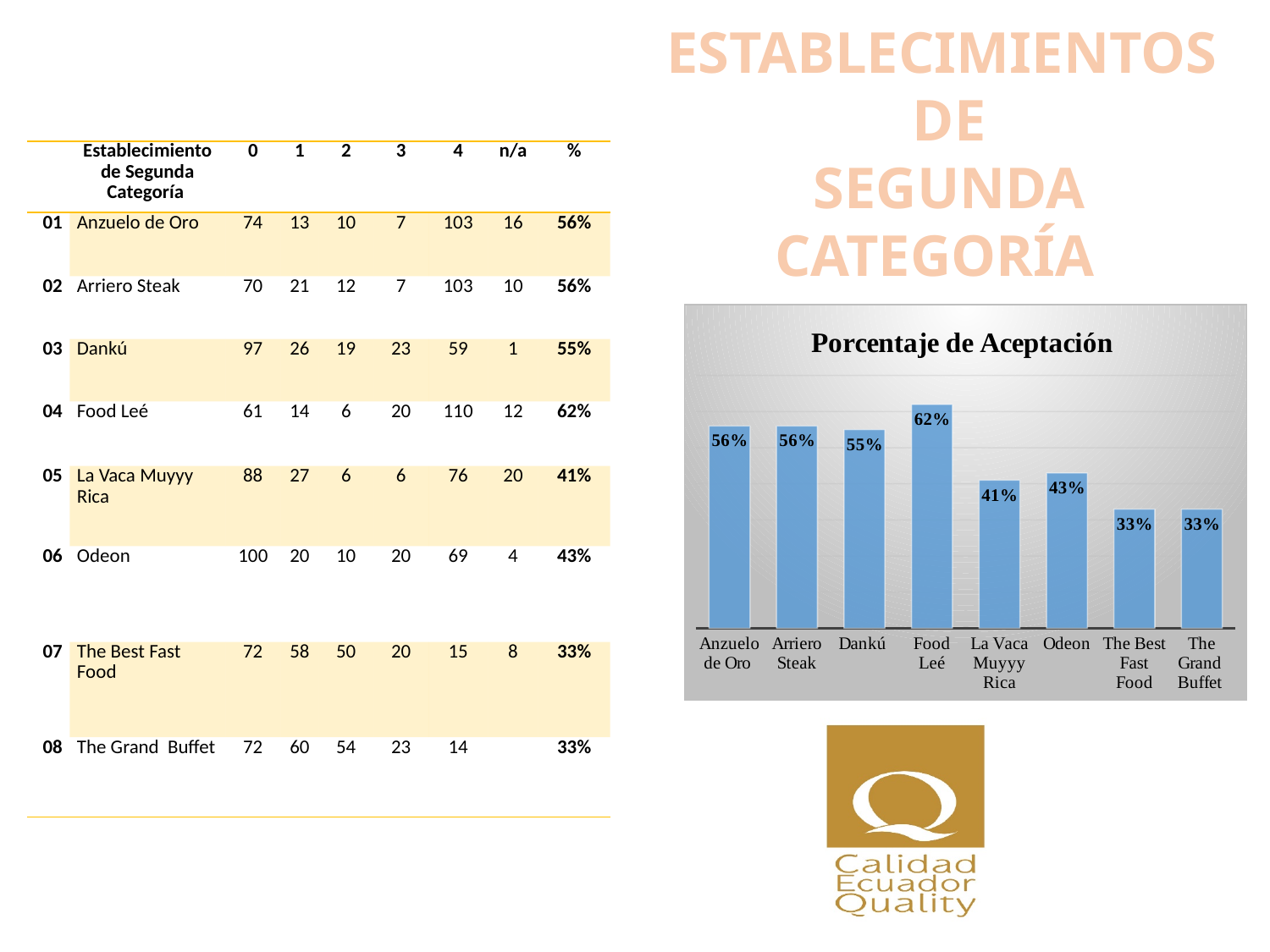
What is the title of the chart on the slide? Porcentaje de Aceptación How many establishments are shown in the Porcentaje de Aceptación chart? 8 What is the value for Food Leé in the Porcentaje de Aceptación chart? 62% What is the value for Odeon in the Porcentaje de Aceptación chart? 43% What is the difference between the values for Food Leé and The Grand Buffet in the Porcentaje de Aceptación chart? 29% Which establishment has the highest value in the Porcentaje de Aceptación chart? Food Leé How many establishments in the Porcentaje de Aceptación chart have a value of 33%? 2 What is the value for La Vaca Muyyy Rica in the Porcentaje de Aceptación chart? 41% What kind of chart is the Porcentaje de Aceptación chart? Bar chart What is the difference between the values for Dankú and Odeon in the Porcentaje de Aceptación chart? 12% What is the value for Dankú in the Porcentaje de Aceptación chart? 55% Which is larger in the Porcentaje de Aceptación chart, the value for Anzuelo de Oro or the value for La Vaca Muyyy Rica? Anzuelo de Oro